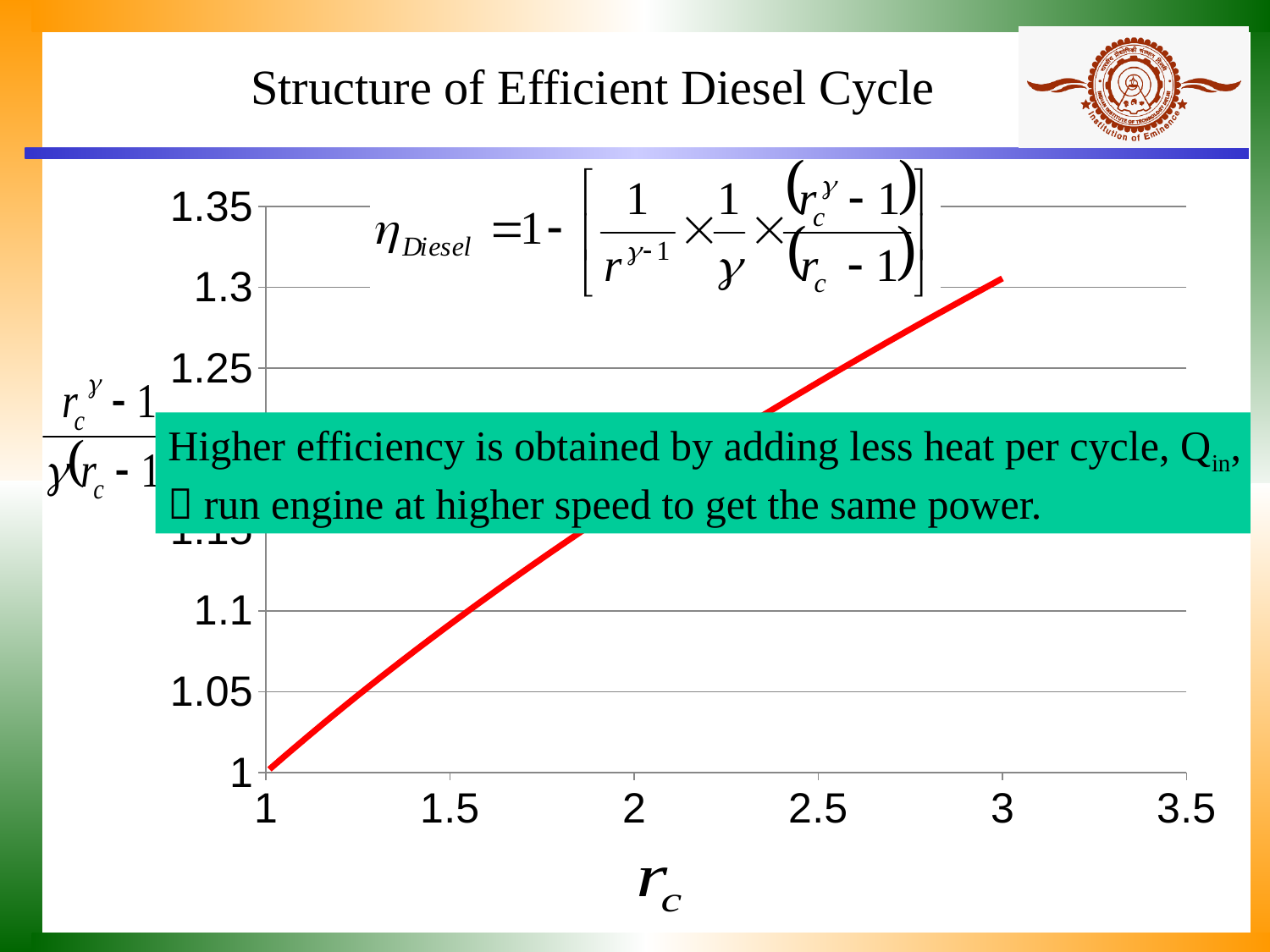
What is the label on the x axis of the chart? r_c At which value of r_c is the plotted curve lowest? 1 Is the value of the curve at r_c = 2.5 greater or less than 1.3? less Is the value of the curve at r_c = 3 greater or less than 1.35? less Is the value of the curve at r_c = 1.5 greater or less than 1.05? greater At which value of r_c does the plotted curve reach its highest point? 3 What kind of chart is shown on the slide? line chart Does the plotted curve rise or fall as r_c increases? rises What colour is the plotted curve? red What is the value of the curve at r_c = 1? 1